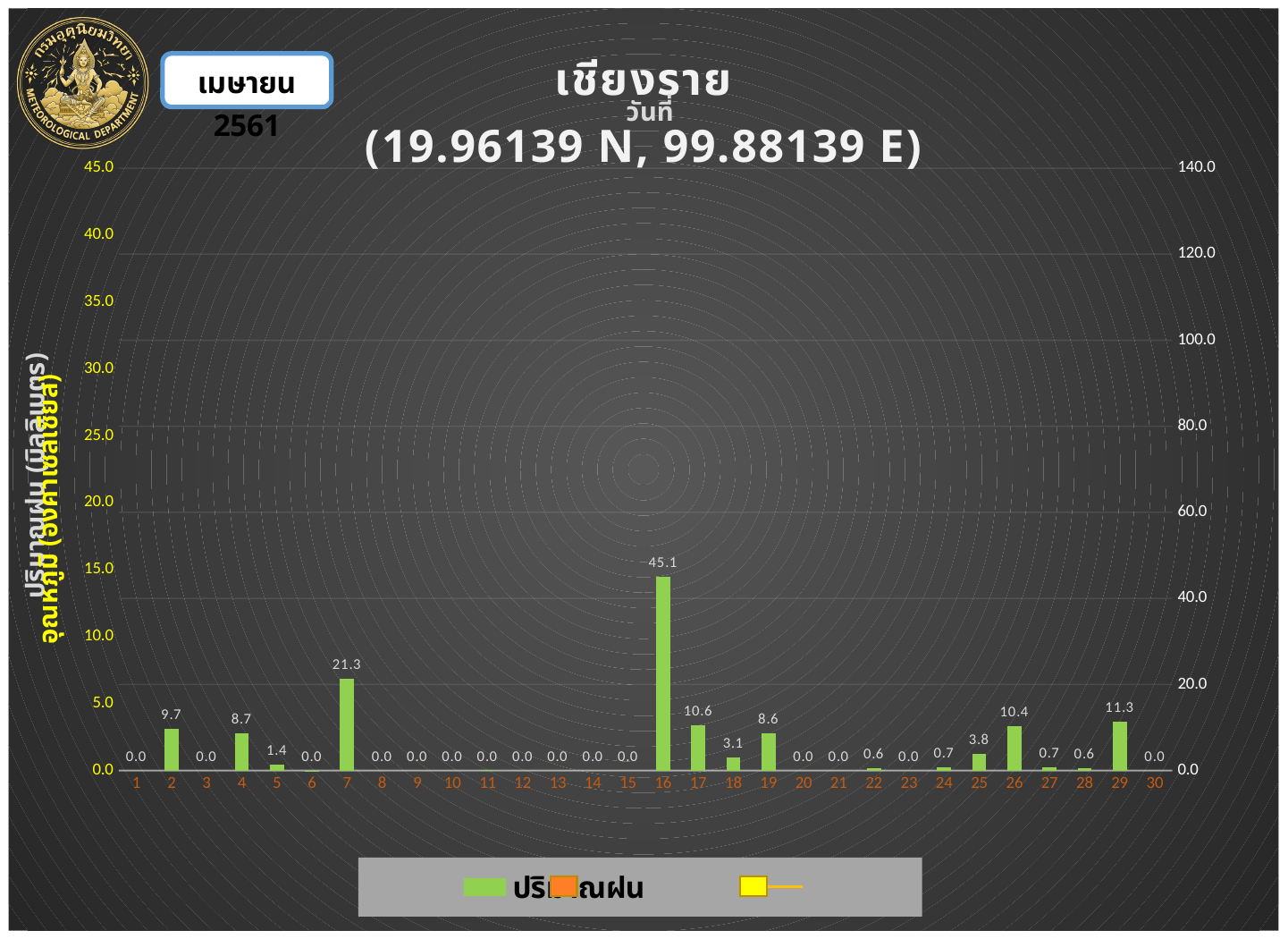
Which day has the highest rainfall value? 16 What is the rainfall value shown for day 16? 45.1 What is the difference between the rainfall values for day 16 and day 7? 23.8 What is the rainfall value shown for day 7? 21.3 How many days are shown on the x axis of the chart? 30 What coordinates are given in the chart title? 19.96139 N, 99.88139 E Which day has the larger rainfall value, day 18 or day 19? Day 19 Which day has the larger rainfall value, day 2 or day 4? Day 2 What is the rainfall value shown for day 29? 11.3 What is the difference between the rainfall values for day 17 and day 26? 0.2 What kind of chart is used to show the rainfall values? Bar chart What is the rainfall value shown for day 25? 3.8